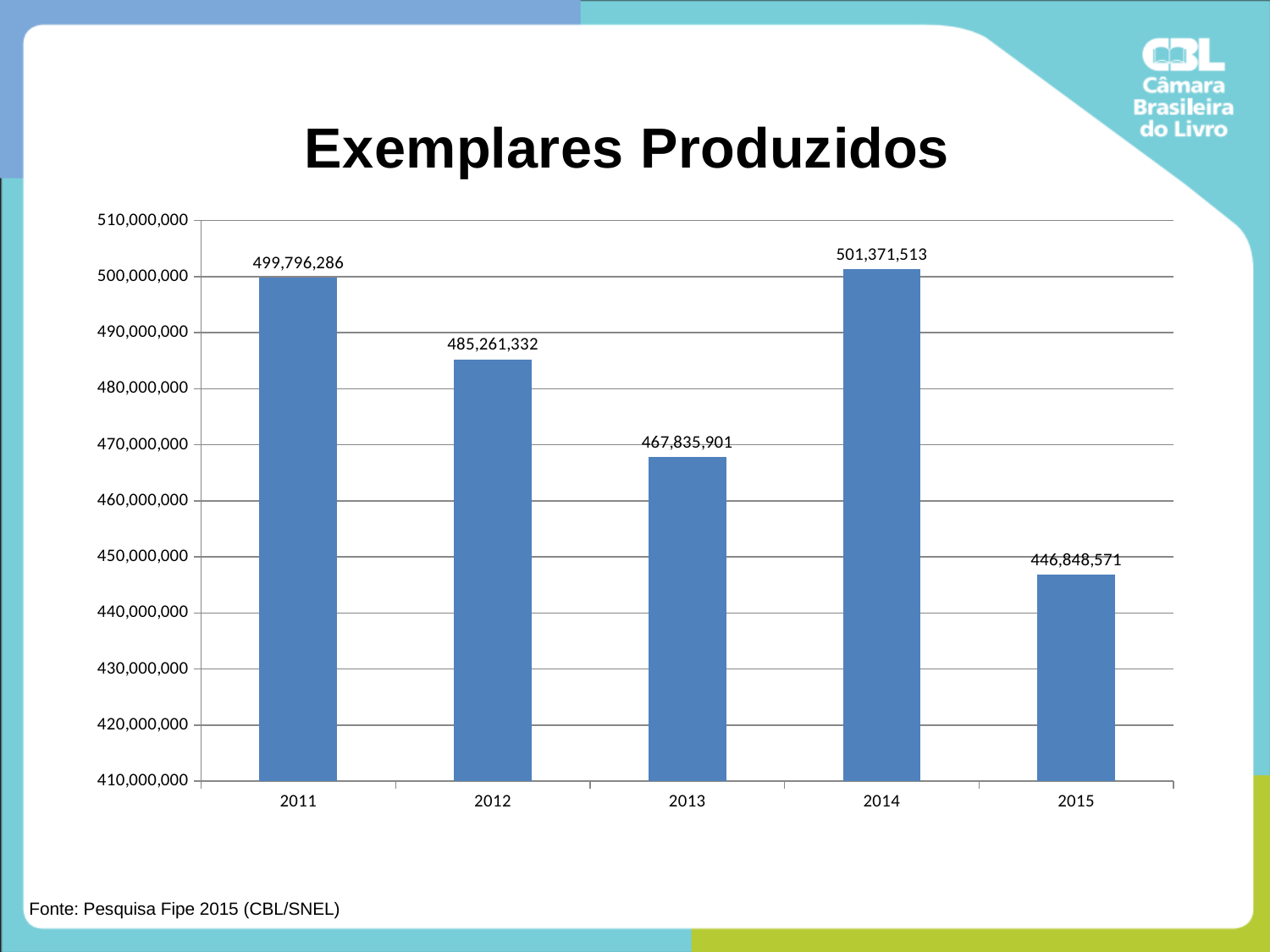
Is the value for 2013 greater or less than 470,000,000? less What kind of chart is this? bar chart What is the value for 2011? 499,796,286 What is the value for 2013? 467,835,901 What is the value for 2015? 446,848,571 Which year has the lowest value? 2015 What is the difference between the values for 2012 and 2013? 17,425,431 Which year has the highest value? 2014 How many years are shown on the x axis? 5 Which is larger, the value for 2012 or the value for 2013? 2012 What is the title of the chart? Exemplares Produzidos What is the difference between the values for 2011 and 2015? 52,947,715